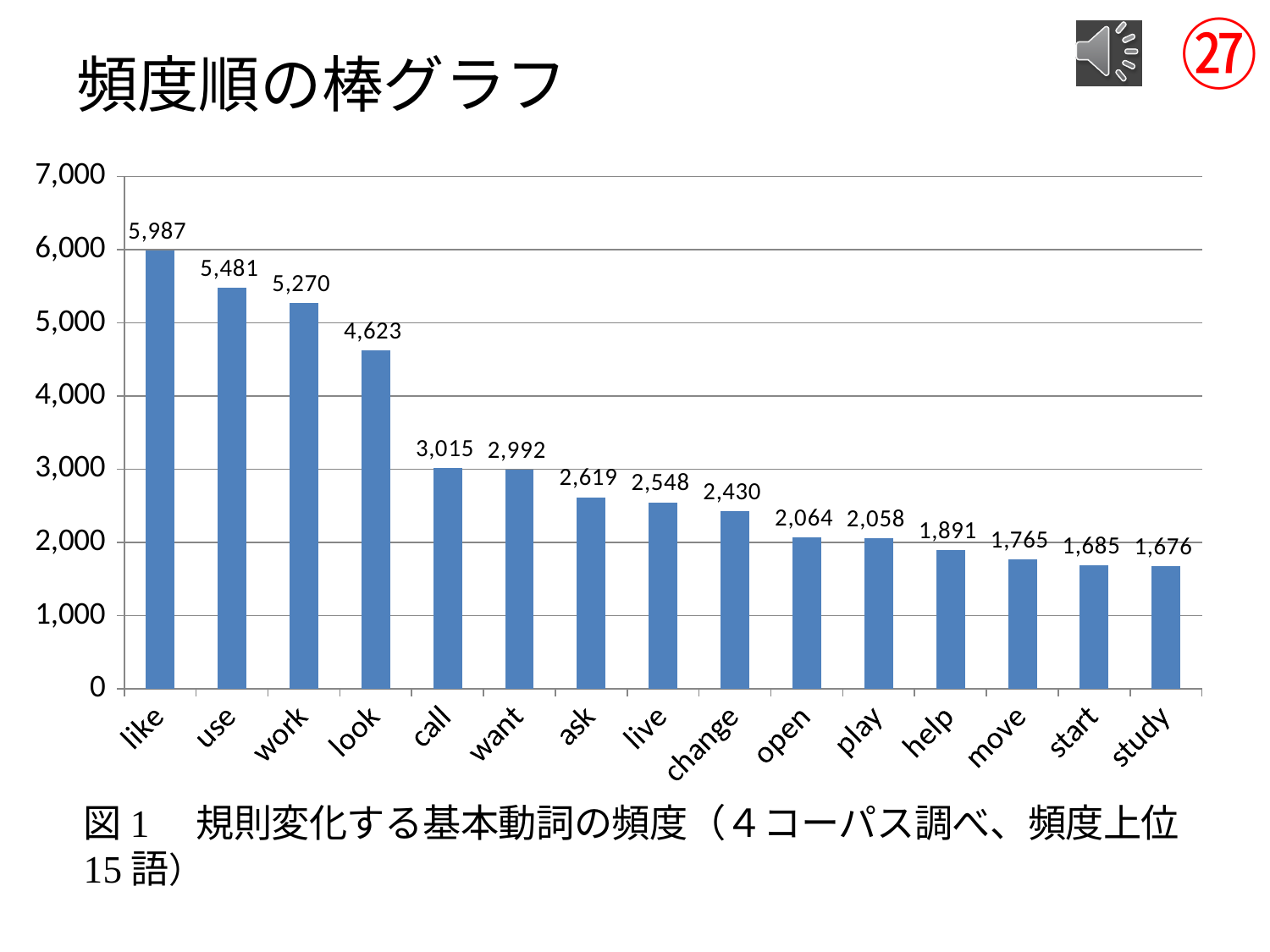
What is the difference between the frequencies of "use" and "work"? 211 What is the frequency value shown for "change"? 2,430 What kind of chart is shown on the slide? bar chart Is the value for "want" greater or less than 3,000? less What is the frequency value shown for "help"? 1,891 What is the difference between the frequencies of "look" and "call"? 1,608 Which verb has the lowest frequency in the chart? study Which verb has the highest frequency in the chart? like Which has a higher frequency, "ask" or "open"? ask Do the values rise or fall from left to right along the x axis? fall How many verbs are shown in the chart? 15 What is the frequency value shown for "like"? 5,987